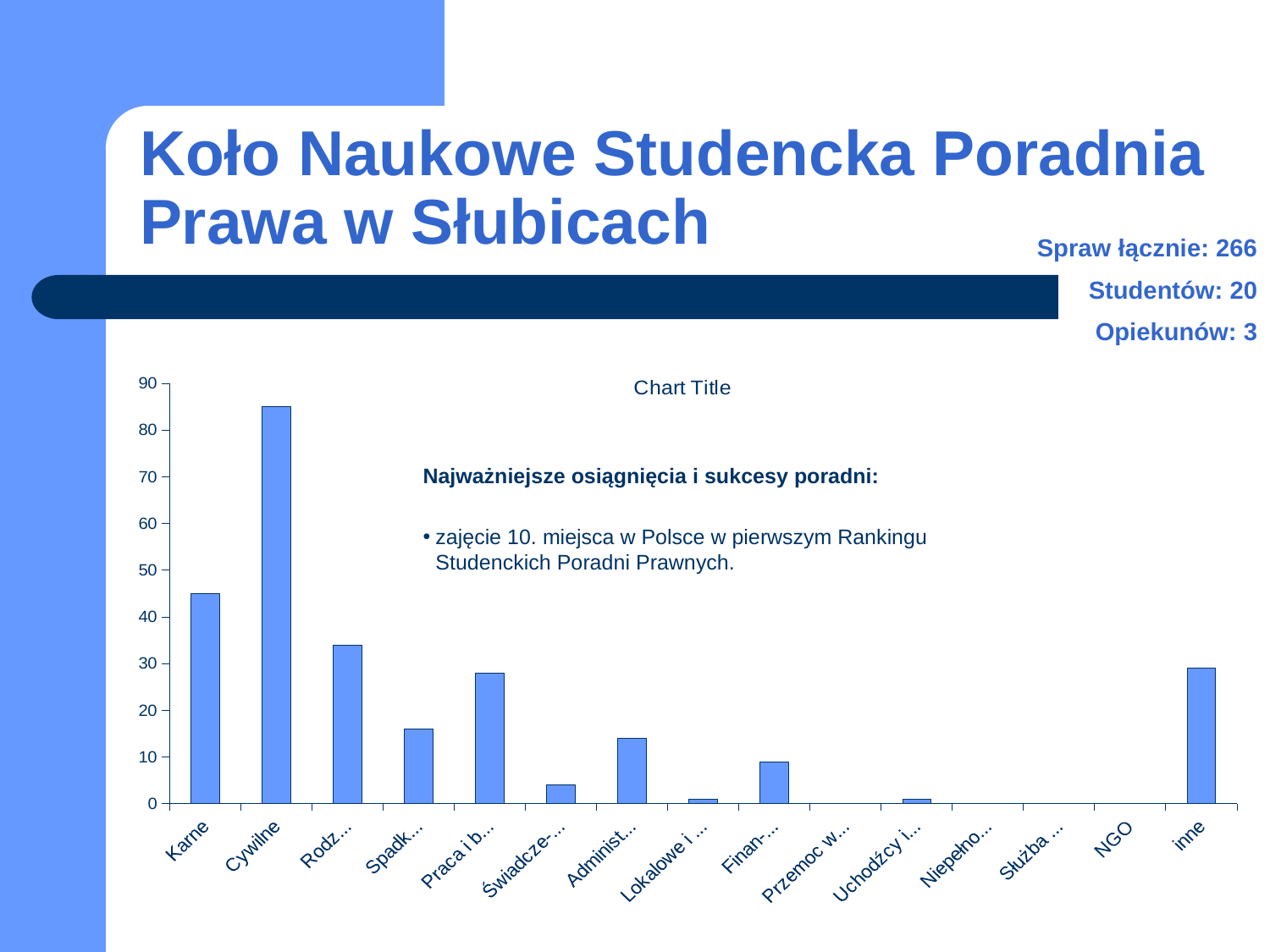
What kind of chart is shown on the slide? bar chart Is the value for Karne greater or less than 50? less Is the value for inne greater or less than 20? greater Is the value for Karne greater or less than 40? greater Which is larger, the value for Karne or the value for inne? Karne Which category has the highest bar in the chart? Cywilne What is the title shown above the chart? Chart Title Which is larger, the value for Karne or the value for Cywilne? Cywilne How many categories are shown on the x axis of the chart? 15 Which is larger, the value for inne or the value for NGO? inne